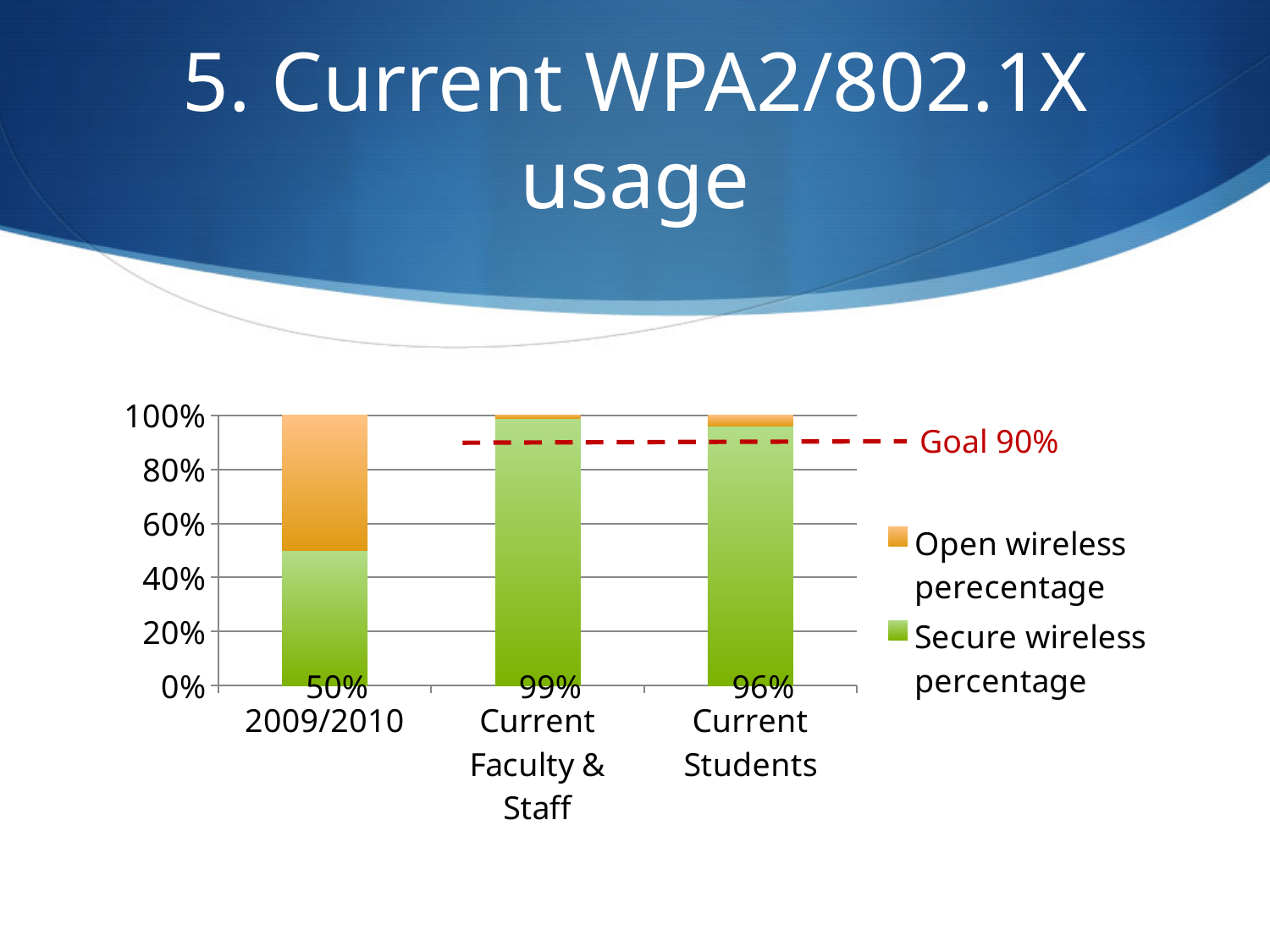
Which category has the highest secure wireless percentage? Current Faculty & Staff Which category has the lowest secure wireless percentage? 2009/2010 What is the difference in secure wireless percentage between Current Faculty & Staff and 2009/2010? 49% How many categories are shown on the x axis? 3 What is the secure wireless percentage for 2009/2010? 50% What kind of chart is shown on the slide? Stacked bar chart What is the secure wireless percentage for Current Students? 96% Which has a larger secure wireless percentage, Current Faculty & Staff or Current Students? Current Faculty & Staff How many series does the legend list? 2 What goal value is marked by the dashed red line? Goal 90% Is the open wireless percentage for 2009/2010 greater or less than 40%? greater What is the secure wireless percentage for Current Faculty & Staff? 99%